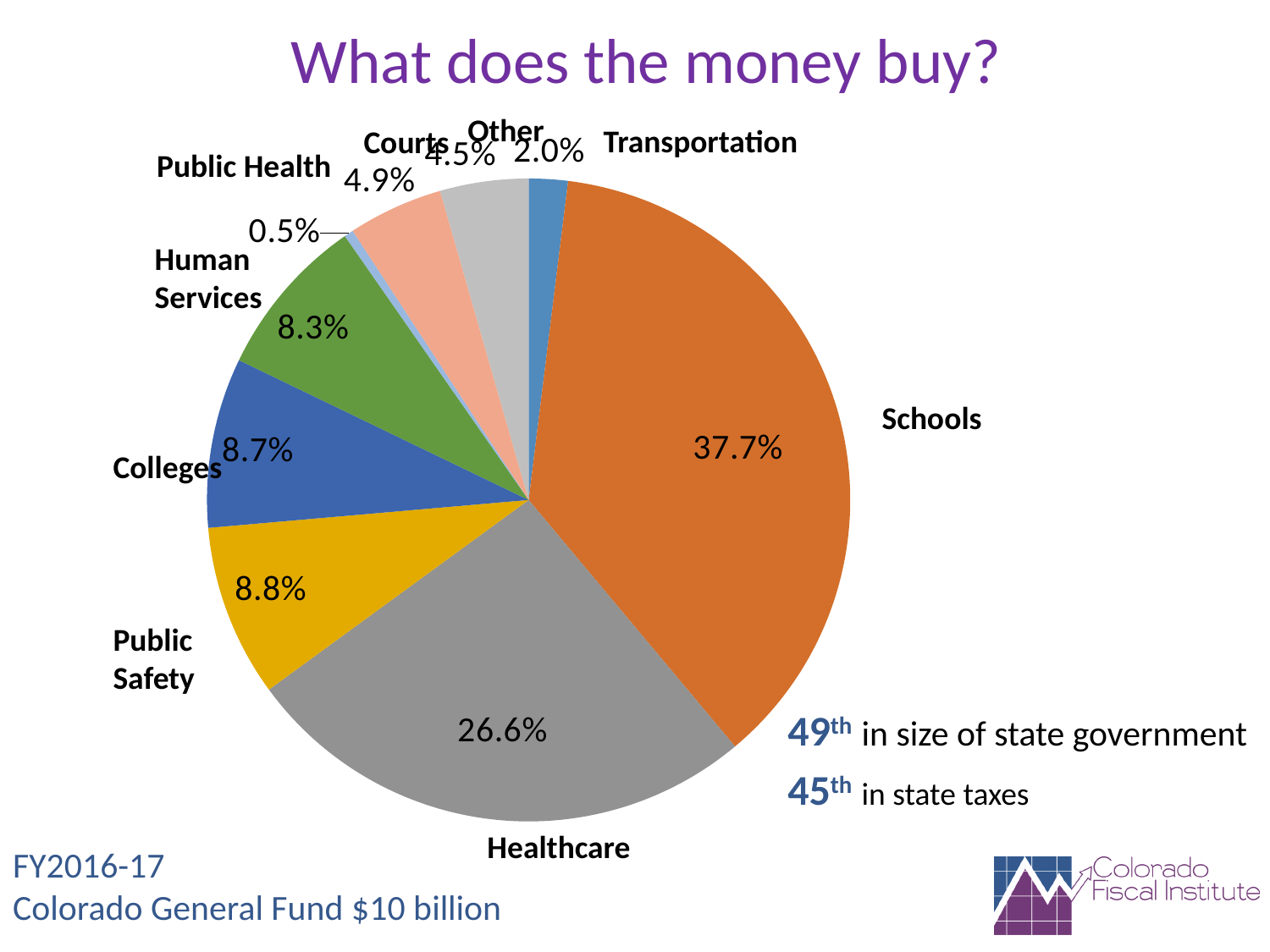
What type of chart is shown on the slide? pie chart What percentage is shown for Human Services? 8.3% What percentage is shown for Transportation? 2.0% Which category has the largest slice of the pie? Schools What is the difference in percentage points between Schools and Healthcare? 11.1 How many categories are shown in the pie chart? 9 Which category has the smallest slice of the pie? Public Health Which is larger, the share for Healthcare or the share for Colleges? Healthcare What is the title of the slide containing the pie chart? What does the money buy? What percentage is shown for Public Health? 0.5% What percentage is shown for Healthcare? 26.6% What share of the pie does Schools account for? 37.7%